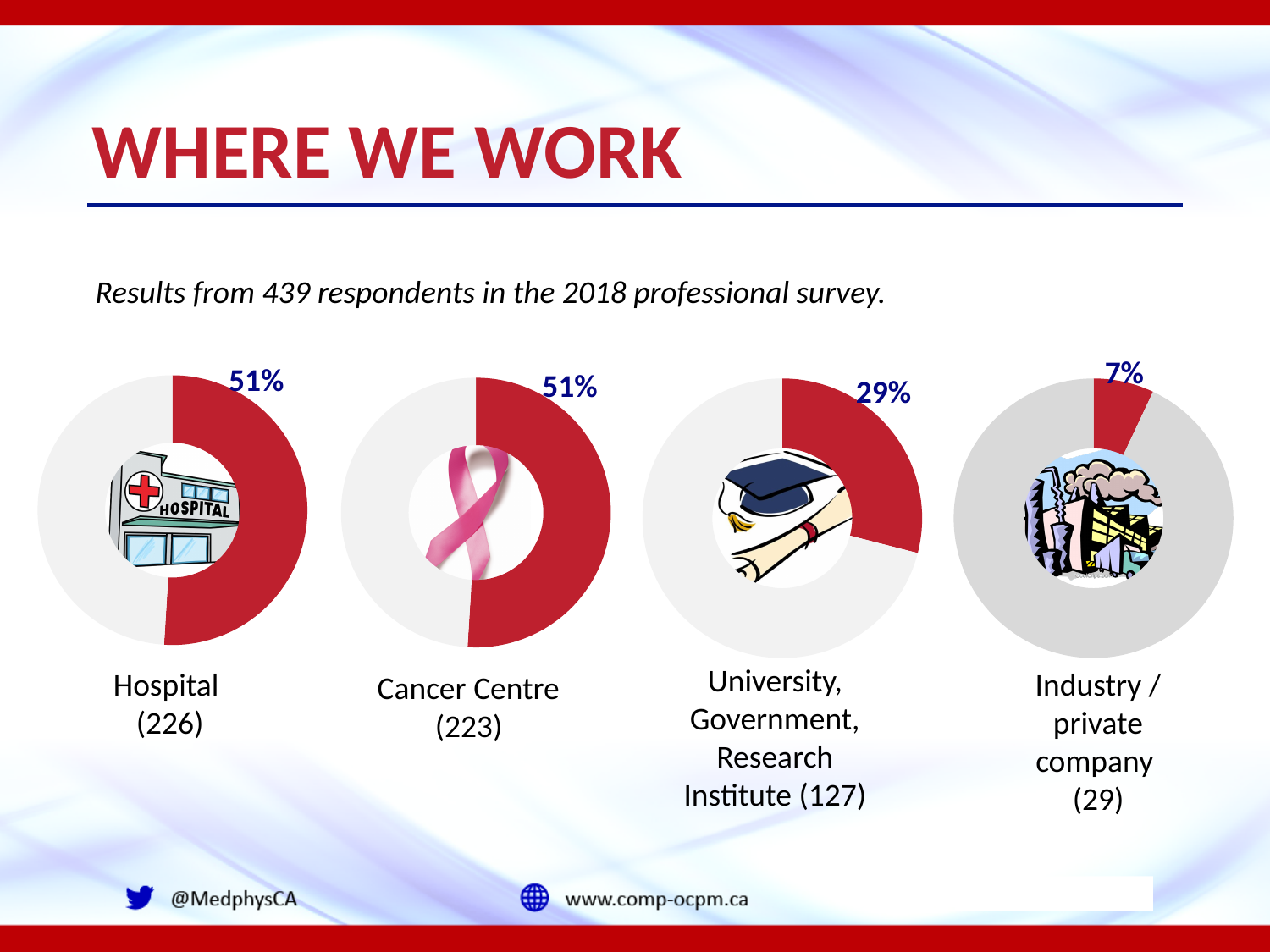
How many respondents took part in the 2018 professional survey, according to the slide? 439 How many respondents are listed for the University, Government, Research Institute chart? 127 What kind of chart is used to show each workplace percentage on the slide? Donut (pie) chart What is the difference in respondent counts between Hospital (226) and Industry / private company (29)? 197 What percentage is shown on the Industry / private company donut chart? 7% Which of the four donut charts shows the lowest percentage? Industry / private company What percentage is shown on the Hospital donut chart? 51% Which is larger, the percentage for Hospital or the percentage for Industry / private company? Hospital How many donut charts are shown on the slide? 4 What percentage is shown on the Cancer Centre donut chart? 51% How many respondents are listed for the Hospital chart? 226 What percentage is shown on the University, Government, Research Institute donut chart? 29%